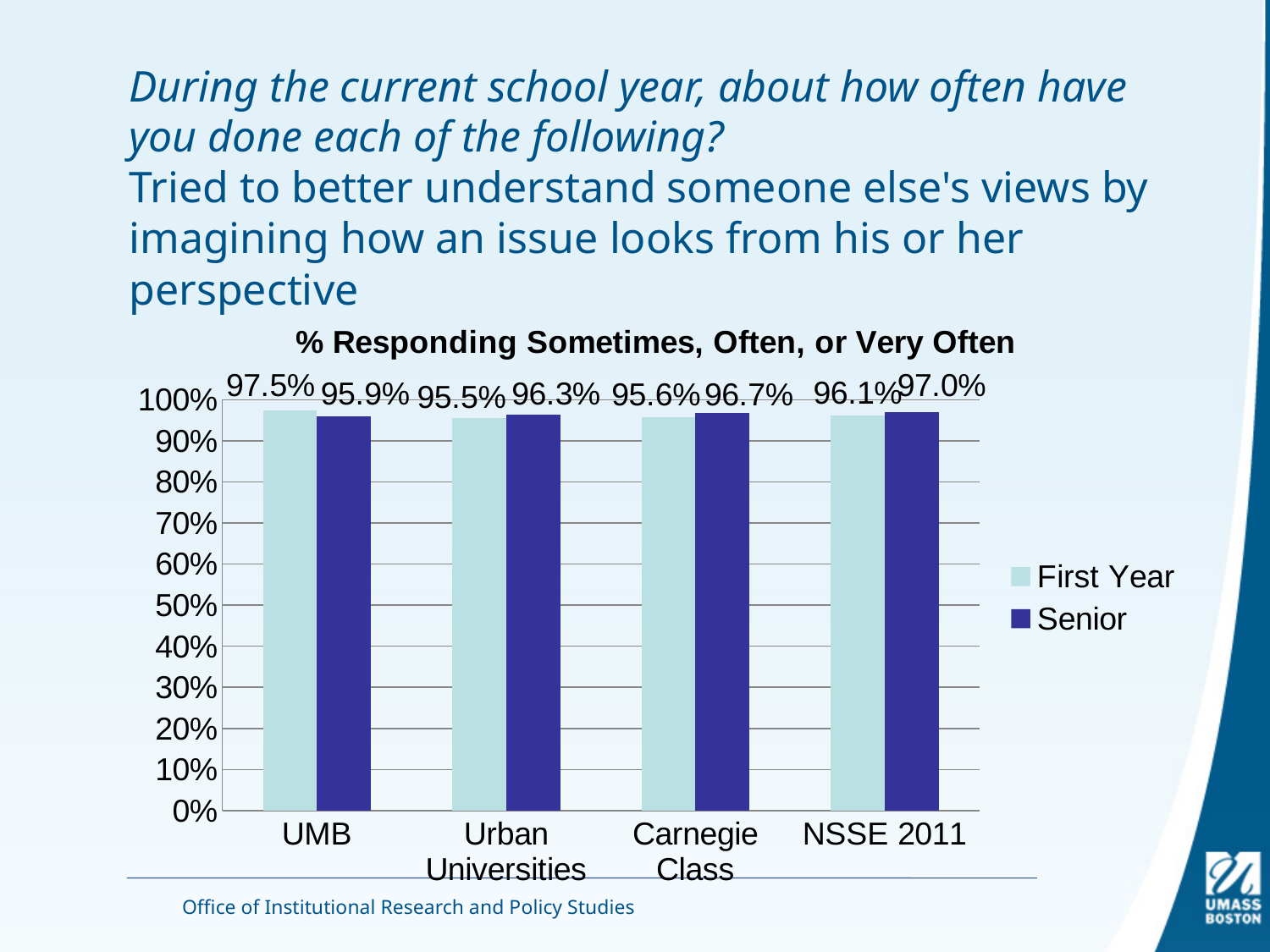
How many categories are shown on the x axis? 4 Which category has the lowest First Year value? Urban Universities What is the difference between the First Year and Senior values for UMB? 1.6% What kind of chart is shown on the slide? Bar chart Which is larger for Carnegie Class, the First Year value or the Senior value? Senior What is the Senior value for Carnegie Class? 96.7% What is the Senior value for NSSE 2011? 97.0% What is the First Year value for Urban Universities? 95.5% Which category has the lowest Senior value? UMB How many series does the legend list? 2 Which category has the highest First Year value? UMB What is the First Year value for UMB? 97.5%